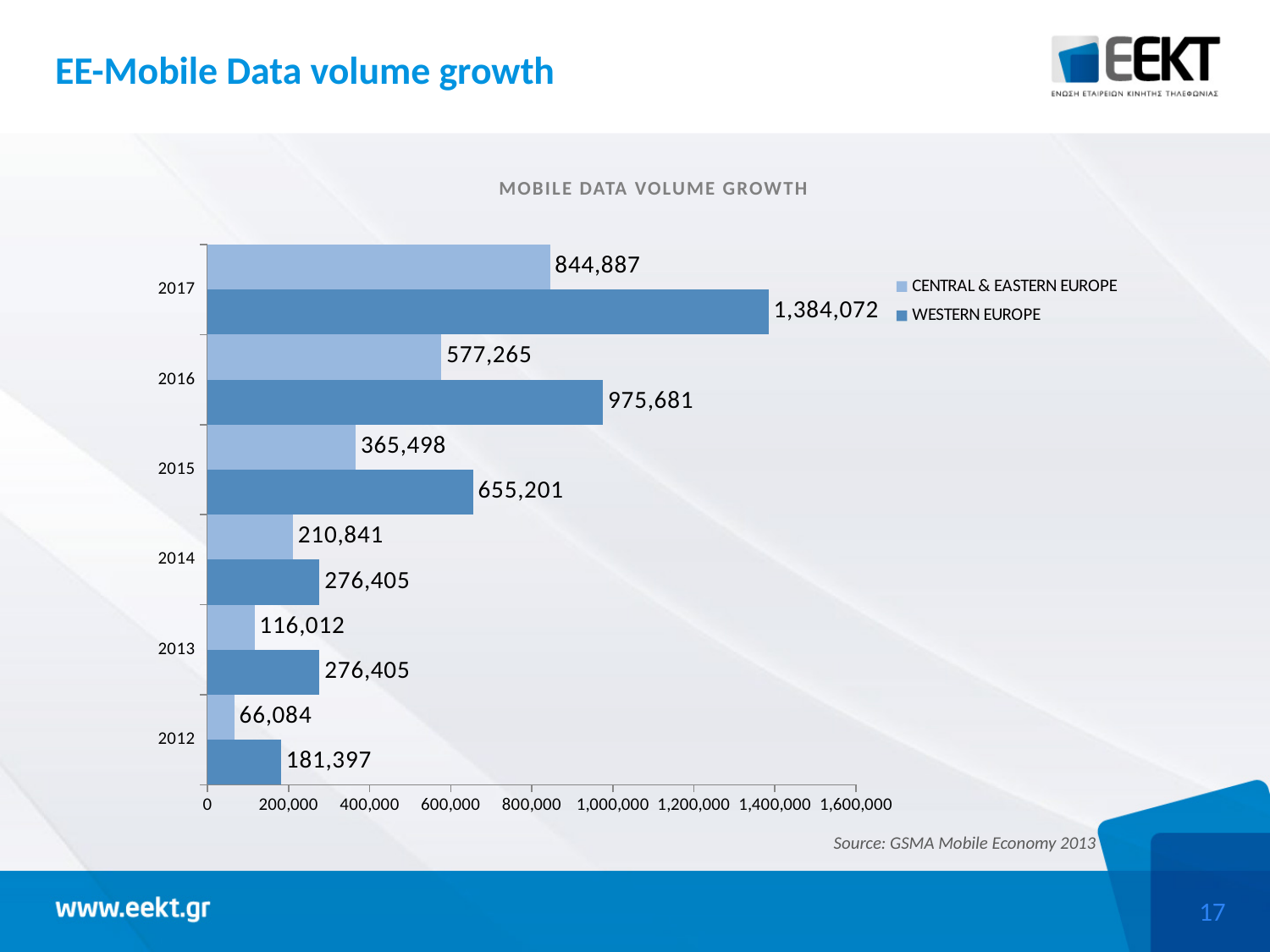
What is the value for Central & Eastern Europe in 2012? 66,084 How many years are shown on the chart? 6 Which year has the highest value for Western Europe? 2017 What is the value for Western Europe in 2017? 1,384,072 What is the value for Western Europe in 2014? 276,405 Which year has the lowest value for Central & Eastern Europe? 2012 What is the difference between Western Europe and Central & Eastern Europe in 2017? 539,185 What is the difference between Western Europe and Central & Eastern Europe in 2012? 115,313 What is the value for Central & Eastern Europe in 2015? 365,498 How many series does the legend list? 2 What kind of chart is shown on the slide? Bar chart Which is larger in 2016, Western Europe or Central & Eastern Europe? Western Europe